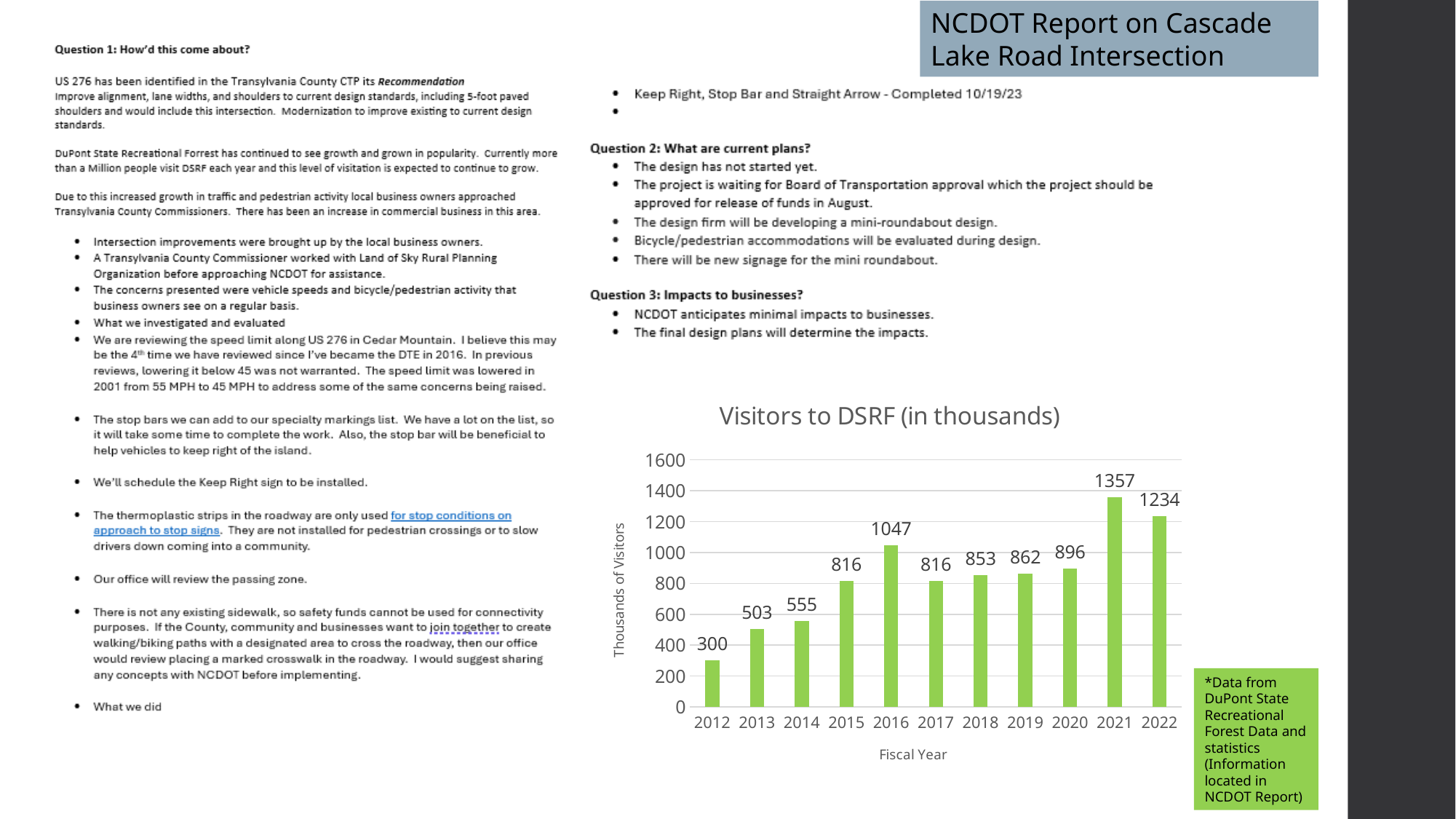
What kind of chart is the Visitors to DSRF chart? bar chart What is the value for 2022 in the Visitors to DSRF chart? 1234 What is the value for 2016 in the Visitors to DSRF chart? 1047 Do the values in the Visitors to DSRF chart generally rise or fall from 2012 to 2021? rise Which fiscal year has the lowest number of visitors to DSRF? 2012 How many fiscal years are shown in the Visitors to DSRF chart? 11 Which fiscal year has the highest number of visitors to DSRF? 2021 Is the value for 2020 in the Visitors to DSRF chart greater or less than 1000? less What is the difference between the 2021 and 2022 values in the Visitors to DSRF chart? 123 What is the title of the chart on the slide? Visitors to DSRF (in thousands) What is the value for 2012 in the Visitors to DSRF chart? 300 Which is larger in the Visitors to DSRF chart, the value for 2013 or the value for 2014? 2014